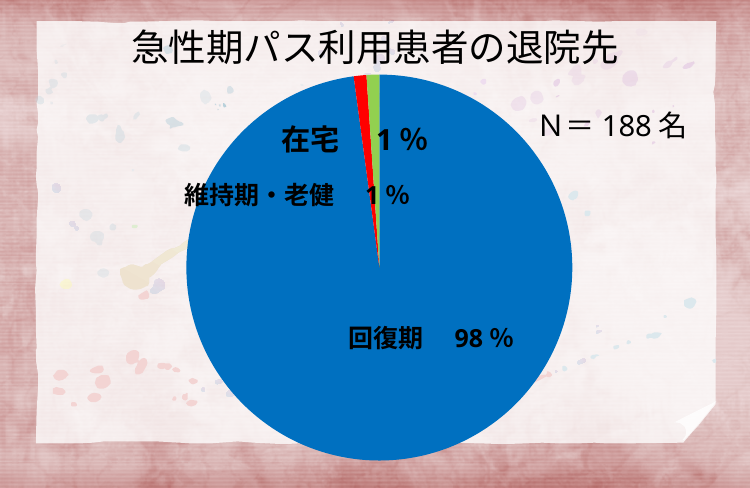
Is the share for 回復期 greater or less than 50%? greater What kind of chart is shown on the slide? pie chart Which category has the largest share of the pie? 回復期 What is the value shown for 維持期・老健? 1% What is the title of the chart? 急性期パス利用患者の退院先 Which is larger, the share for 回復期 or the share for 在宅? 回復期 What share of the pie does 回復期 account for? 98% What is the sample size (N) stated on the slide? 188名 How many categories are shown in the pie chart? 3 What is the value shown for 在宅? 1% What is the difference between the share for 回復期 and the share for 維持期・老健? 97%